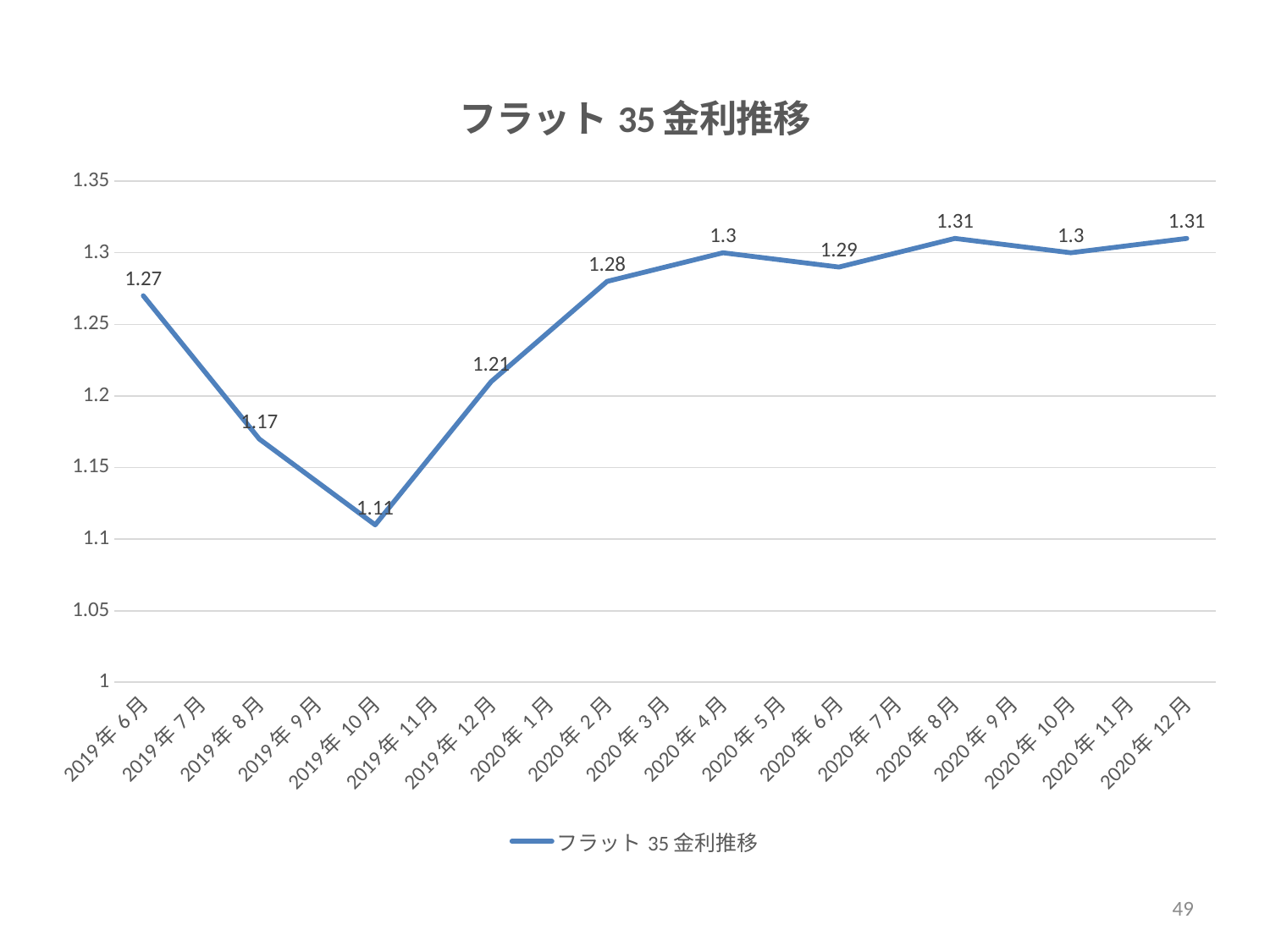
What kind of chart is this? line chart What is the value for 2019年6月? 1.27 Which is larger, the value for 2019年8月 or the value for 2019年12月? 2019年12月 What is the difference between the values for 2019年6月 and 2019年10月? 0.16 How many months are shown on the x axis? 19 What is the value for 2020年8月? 1.31 What is the value for 2019年10月? 1.11 Do the values rise or fall from 2019年10月 to 2020年4月? rise Which month has the lowest value? 2019年10月 What is the value for 2020年2月? 1.28